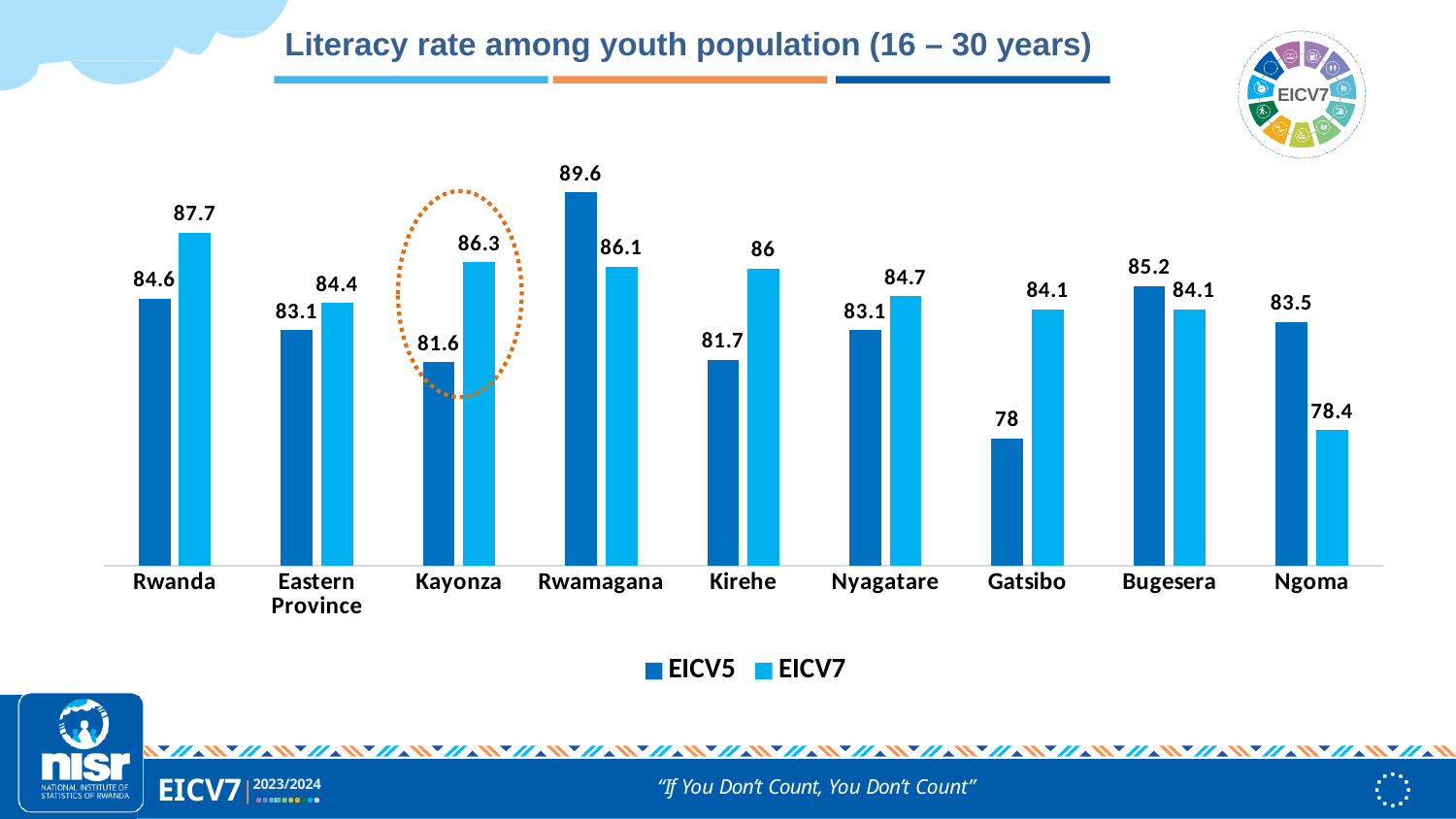
What is the EICV5 literacy rate for Gatsibo? 78 Which category has the highest EICV5 literacy rate? Rwamagana Which category has the highest EICV7 literacy rate? Rwanda How many categories are shown on the x axis? 9 How many series does the legend list? 2 What is the EICV7 literacy rate for Kayonza? 86.3 What kind of chart is shown on the slide? Bar chart What is the difference between the EICV7 and EICV5 literacy rates for Kayonza? 4.7 What is the EICV7 literacy rate for Ngoma? 78.4 What is the difference between the EICV7 and EICV5 literacy rates for Gatsibo? 6.1 Which category has the lowest EICV7 literacy rate? Ngoma For Ngoma, which is larger: the EICV5 or the EICV7 literacy rate? EICV5